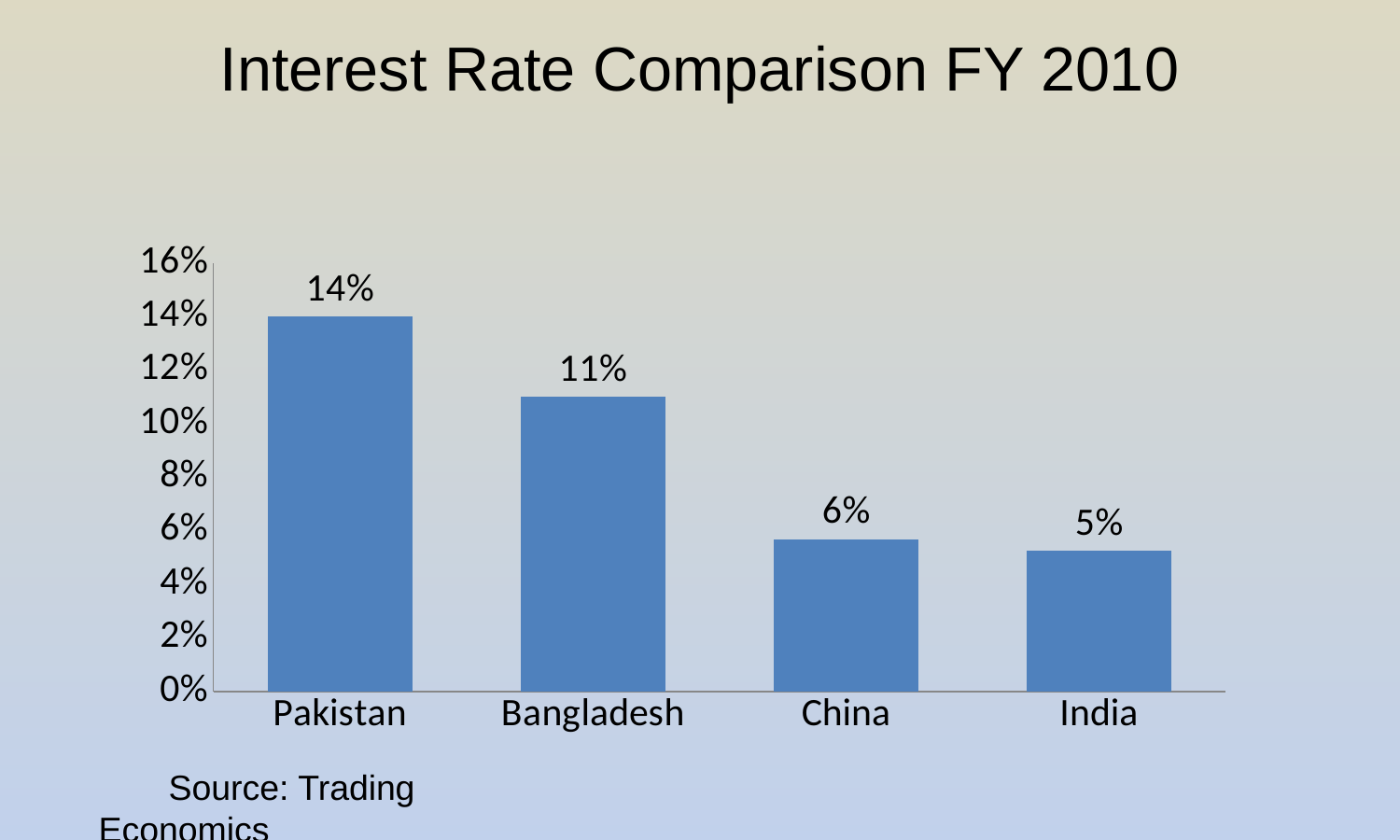
Is the value for China greater or less than 8%? less What is the interest rate shown for Pakistan? 14% What is the interest rate shown for China? 6% What is the interest rate shown for Bangladesh? 11% Which country has the highest interest rate on the chart? Pakistan Which country has the lowest interest rate on the chart? India Which has a higher interest rate, Bangladesh or China? Bangladesh What is the difference between the interest rates of Pakistan and Bangladesh? 3% What is the interest rate shown for India? 5% What kind of chart is shown on the slide? Bar chart How many countries are shown on the chart? 4 What is the title of the chart? Interest Rate Comparison FY 2010